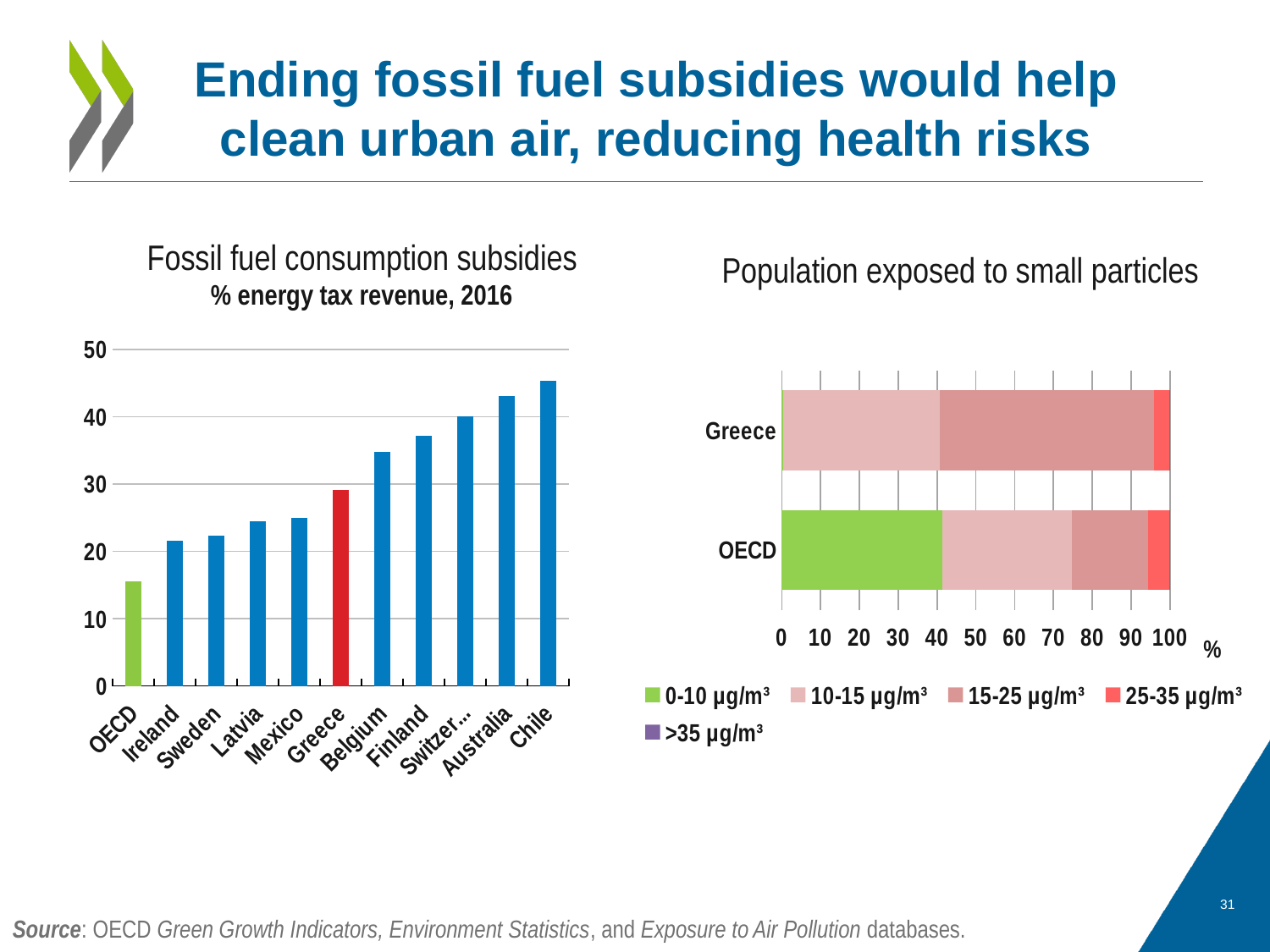
In the 'Fossil fuel consumption subsidies' chart, is the value for OECD greater or less than 20? less In the 'Fossil fuel consumption subsidies' chart, how many countries/categories are shown on the x axis? 11 In the 'Fossil fuel consumption subsidies' chart, what colour is the bar for Greece? red In the 'Population exposed to small particles' chart, how many categories are shown on the vertical axis? 2 In the 'Fossil fuel consumption subsidies' chart, which category has the lowest value? OECD In the 'Fossil fuel consumption subsidies' chart, do the values generally rise or fall from left to right along the x axis? rise In the 'Population exposed to small particles' chart, how many series does the legend list? 5 What kind of chart is the 'Fossil fuel consumption subsidies' chart on the left? bar chart In the 'Fossil fuel consumption subsidies' chart, which is larger, the value for Australia or the value for Mexico? Australia In the 'Fossil fuel consumption subsidies' chart, is the value for Finland greater or less than 30? greater In the 'Fossil fuel consumption subsidies' chart, is the value for Chile greater or less than 40? greater In the 'Fossil fuel consumption subsidies' chart, which category has the highest value? Chile